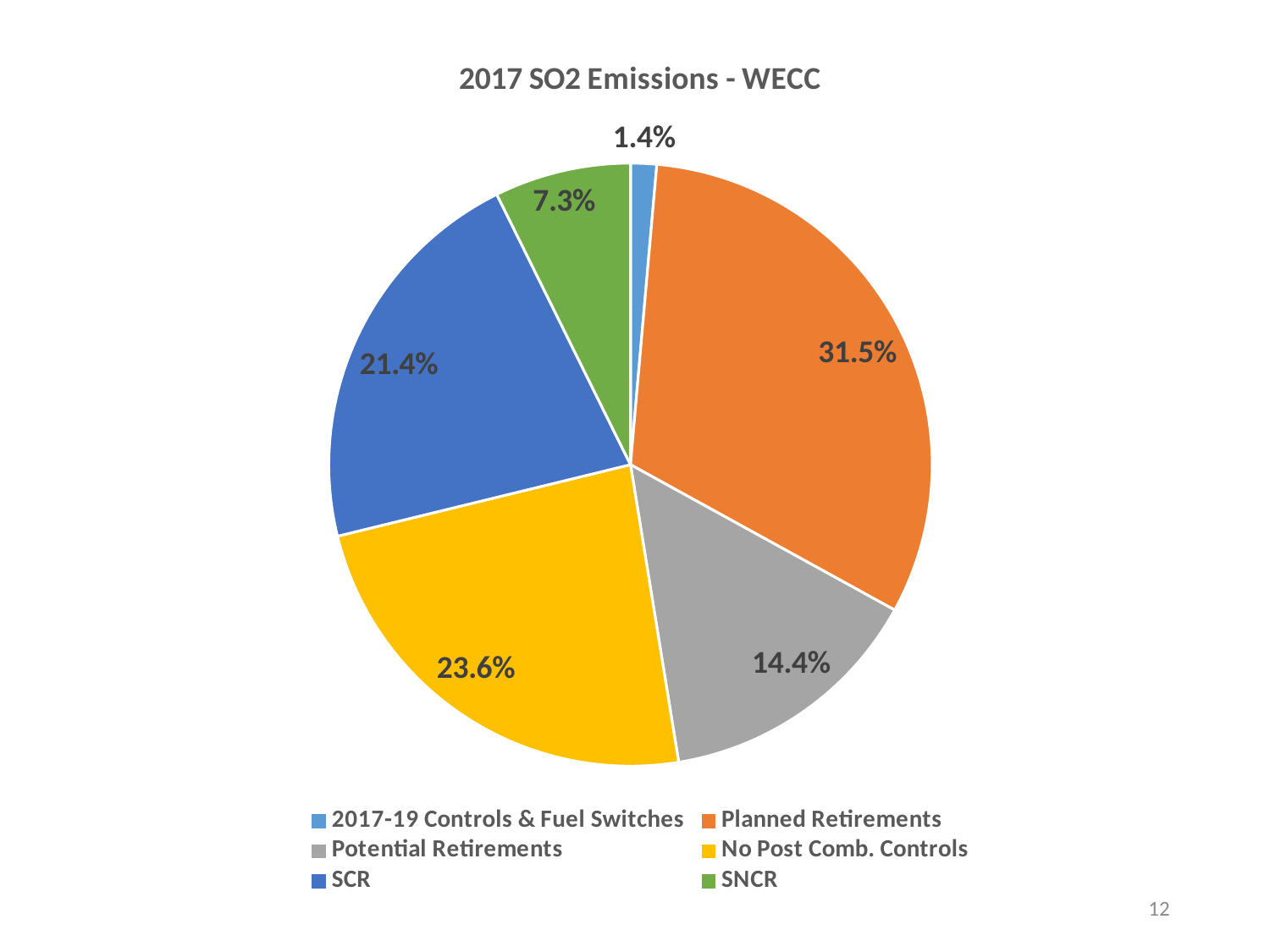
What share of 2017 SO2 emissions is attributed to Planned Retirements? 31.5% What is the title of the chart? 2017 SO2 Emissions - WECC Which category has the smallest share of the pie? 2017-19 Controls & Fuel Switches Which category has the largest share of the pie? Planned Retirements What is the difference in percentage points between Planned Retirements and Potential Retirements? 17.1 What share does the No Post Comb. Controls slice represent? 23.6% Which is larger, the share for SCR or the share for No Post Comb. Controls? No Post Comb. Controls What is the value shown for Potential Retirements? 14.4% How many slices does the pie chart have? 6 What percentage of the pie is labelled SCR? 21.4% What percentage is shown for SNCR? 7.3% What type of chart is shown on the slide? pie chart